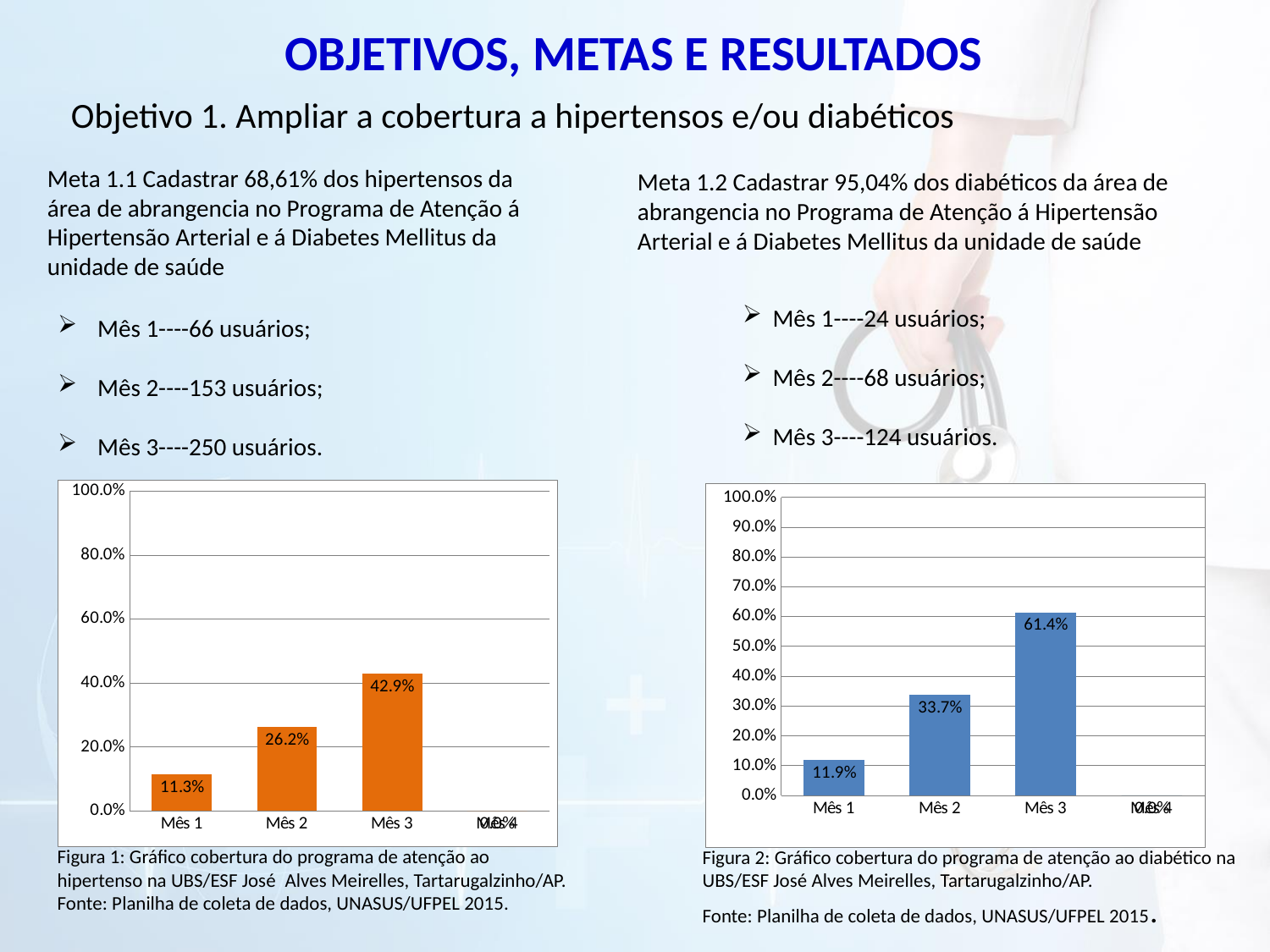
In the right chart (Figura 2, diabético), what is the value for Mês 3? 61.4% In the left chart (Figura 1, hipertenso), what is the value for Mês 3? 42.9% In the left chart (Figura 1, hipertenso), which month has the highest value? Mês 3 What colour are the bars in the left chart (Figura 1, hipertenso)? orange What type of chart is the right chart (Figura 2, diabético)? bar chart In the right chart (Figura 2, diabético), which month has the highest value? Mês 3 In the right chart (Figura 2, diabético), what is the value for Mês 1? 11.9% In the right chart (Figura 2, diabético), what is the difference between Mês 3 and Mês 2? 27.7% Which is larger: Mês 3 in the left chart (Figura 1) or Mês 3 in the right chart (Figura 2)? Mês 3 in the right chart (Figura 2) In the left chart (Figura 1, hipertenso), what is the difference between Mês 2 and Mês 1? 14.9% In the left chart (Figura 1, hipertenso), what is the value for Mês 2? 26.2% In the left chart (Figura 1, hipertenso), do the values rise or fall from Mês 1 to Mês 3? rise